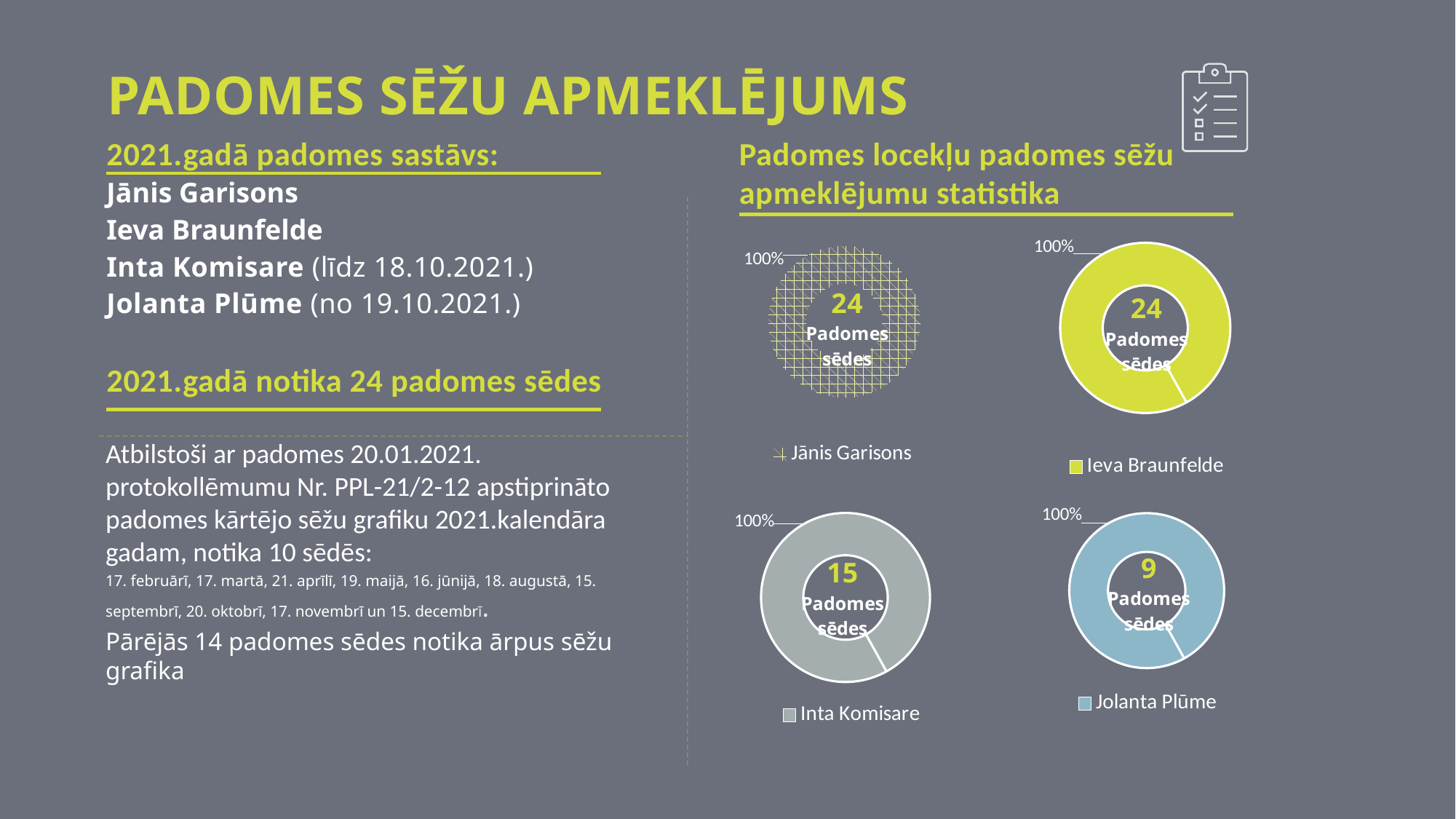
In the Jānis Garisons chart, what percentage is shown as the data label? 100% How many meetings (Padomes sēdes) are shown in the centre of the Ieva Braunfelde chart? 24 Which of the four charts shows the smallest number of meetings in its centre? Jolanta Plūme How many doughnut charts are on the slide? 4 Which shows more meetings in its centre, the Ieva Braunfelde chart or the Jolanta Plūme chart? Ieva Braunfelde What kind of chart is used for Jānis Garisons? doughnut chart What is the difference between the number of meetings shown in the Jānis Garisons chart and the Inta Komisare chart? 9 What is the difference between the number of meetings shown in the Inta Komisare chart and the Jolanta Plūme chart? 6 How many meetings (Padomes sēdes) are shown in the centre of the Inta Komisare chart? 15 How many meetings (Padomes sēdes) are shown in the centre of the Jolanta Plūme chart? 9 How many legend entries does the Jolanta Plūme chart list? 1 What is the legend entry of the bottom-left chart? Inta Komisare